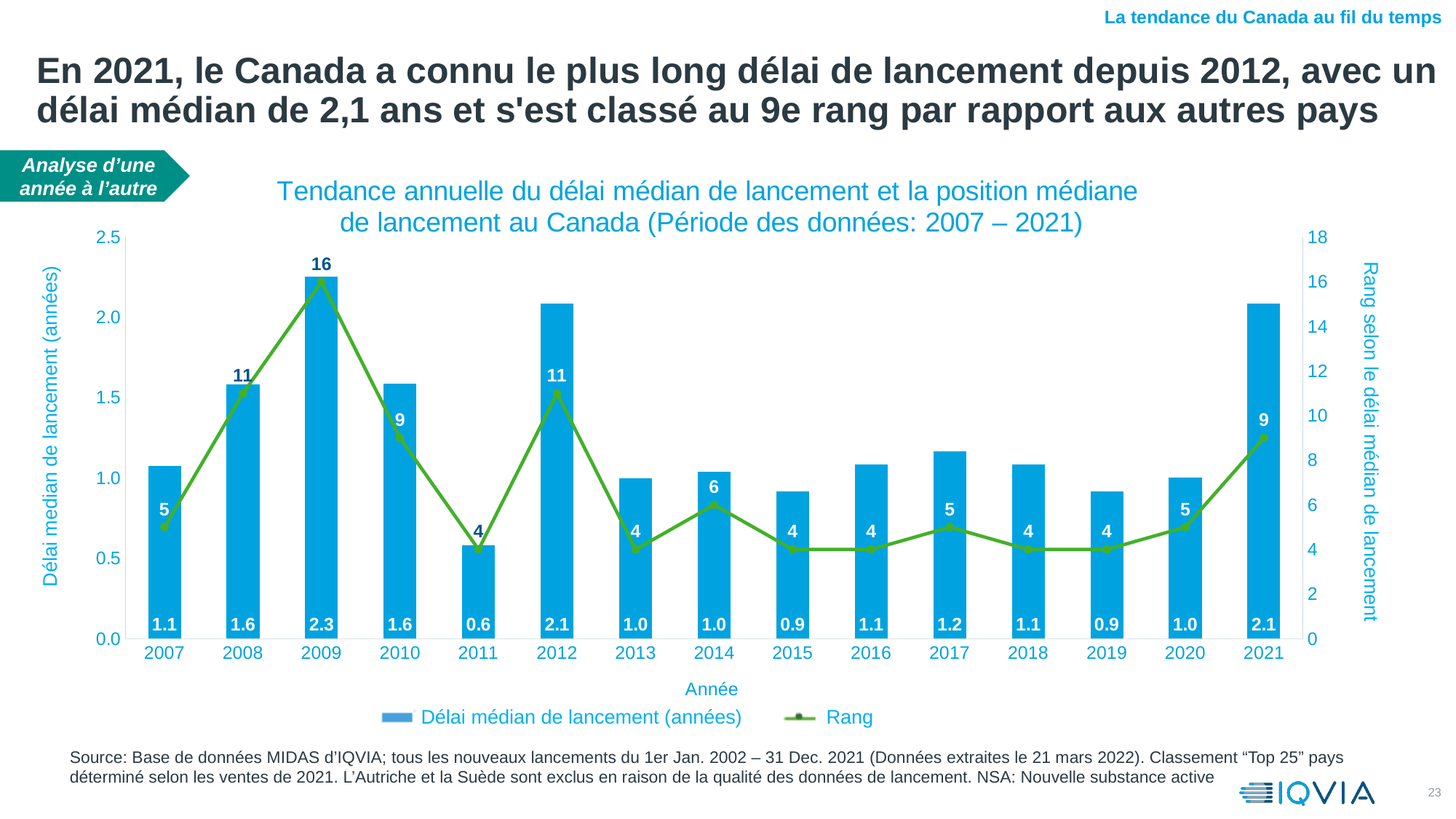
Which year has the highest Rang value? 2009 Does the median launch delay rise or fall from 2009 to 2011? Fall Which year has the lowest median launch delay? 2011 Which year has a larger median launch delay, 2012 or 2017? 2012 How many years are shown on the x axis of the chart? 15 What is the median launch delay (Délai médian de lancement) for 2009? 2.3 What is the Rang value for 2021? 9 What is the median launch delay shown for 2011? 0.6 Which year has the highest median launch delay? 2009 What is the difference between the median launch delay in 2021 and in 2020? 1.1 How many series does the legend list? 2 What kind of chart is used to show the median launch delay? Bar chart